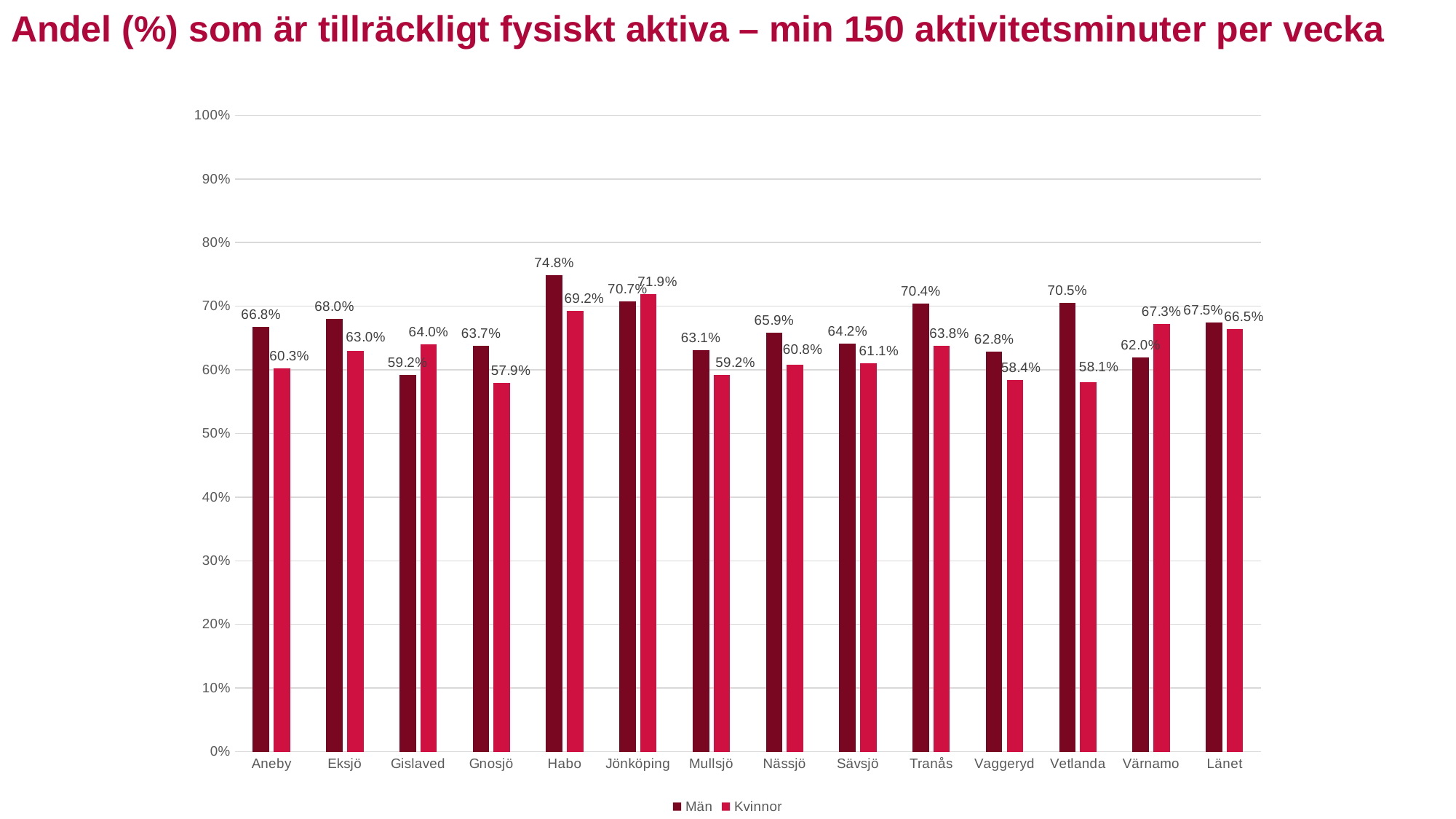
What is the difference between Män and Kvinnor in Aneby? 6.5 percentage points Which category has the lowest value for Kvinnor? Gnosjö Which municipality has the highest value for Män? Habo How many categories are shown on the x axis? 14 What is the value for Kvinnor in Värnamo? 67.3% How many series does the legend list? 2 In Gislaved, which is larger, the value for Män or for Kvinnor? Kvinnor What is the difference between Män and Kvinnor in Habo? 5.6 percentage points Which category has the highest value for Kvinnor? Jönköping What is the value for Män in Habo? 74.8% What is the value for Kvinnor in Länet? 66.5% What kind of chart is shown on the slide? Bar chart